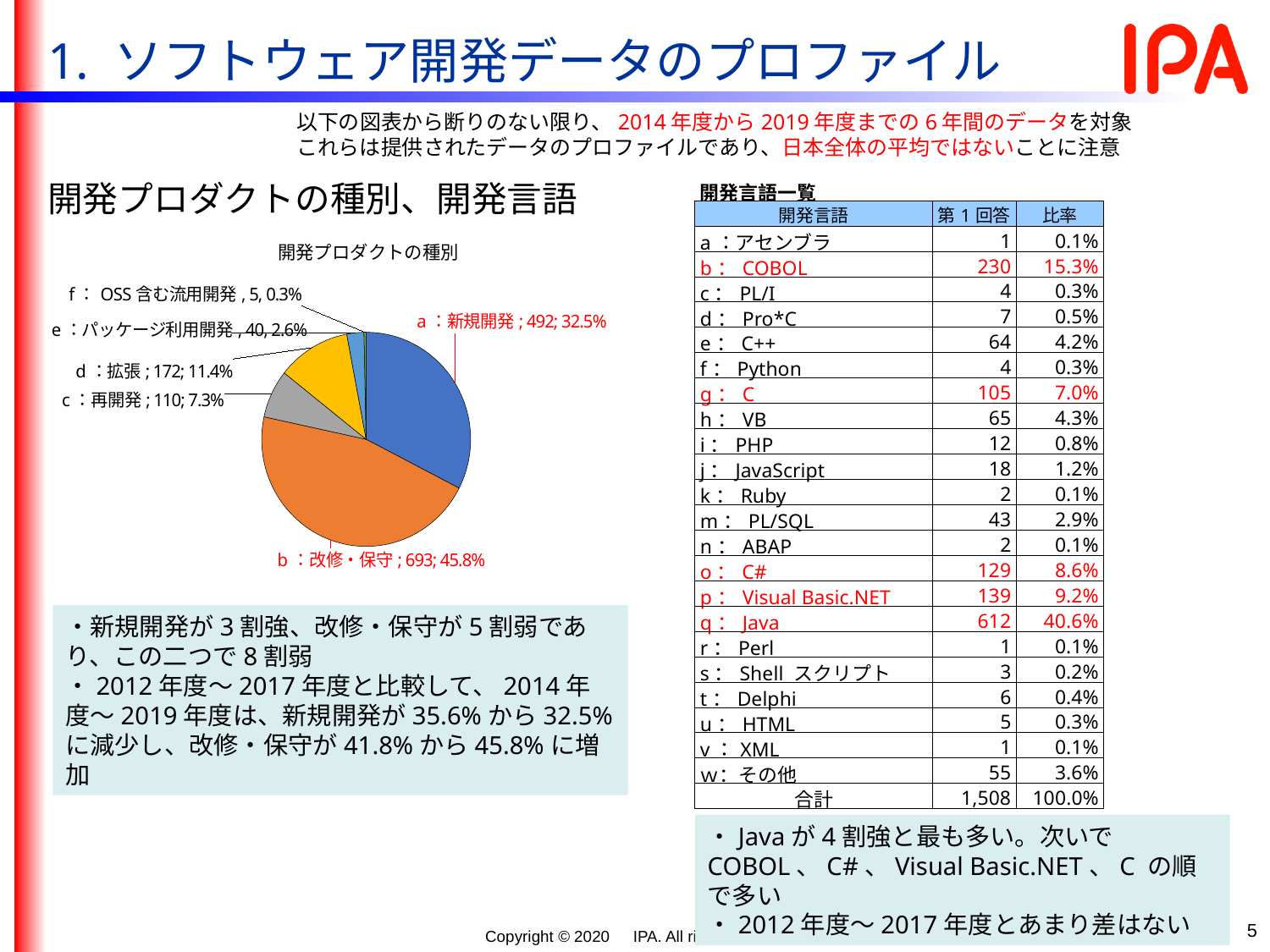
In the 開発プロダクトの種別 pie chart, what is the count for d：拡張? 172 In the 開発プロダクトの種別 pie chart, what is the difference in count between b：改修・保守 and a：新規開発? 201 In the 開発プロダクトの種別 pie chart, what percentage share does c：再開発 have? 7.3% In the 開発プロダクトの種別 pie chart, which is larger, c：再開発 or d：拡張? d：拡張 In the 開発プロダクトの種別 pie chart, what is the count for a：新規開発? 492 In the 開発プロダクトの種別 pie chart, what percentage share does b：改修・保守 have? 45.8% What kind of chart is shown under the heading 開発プロダクトの種別? pie chart In the 開発プロダクトの種別 pie chart, what is the count for e：パッケージ利用開発? 40 What is the title of the pie chart on the slide? 開発プロダクトの種別 Which category has the largest slice in the 開発プロダクトの種別 pie chart? b：改修・保守 How many slices does the 開発プロダクトの種別 pie chart have? 6 Which category has the smallest slice in the 開発プロダクトの種別 pie chart? f：OSS含む流用開発